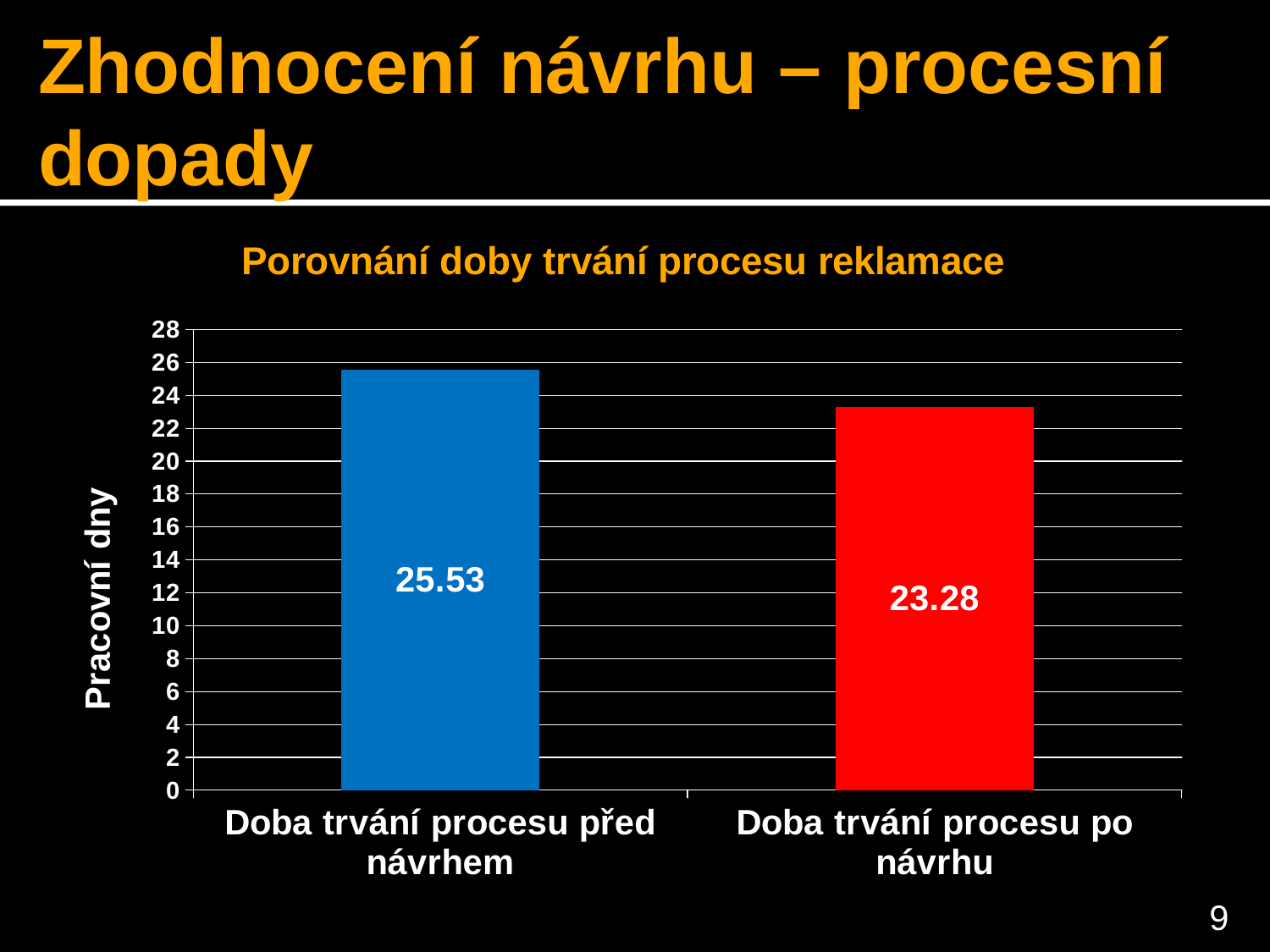
How many categories are shown in the chart? 2 What is the value for "Doba trvání procesu po návrhu"? 23.28 Which is larger: the value for "Doba trvání procesu před návrhem" or the value for "Doba trvání procesu po návrhu"? Doba trvání procesu před návrhem What is the difference between the value for "Doba trvání procesu před návrhem" and the value for "Doba trvání procesu po návrhu"? 2.25 What kind of chart is shown on the slide? bar chart What is the title of the chart? Porovnání doby trvání procesu reklamace Which category has the lowest value? Doba trvání procesu po návrhu Which category has the highest value? Doba trvání procesu před návrhem Is the value for "Doba trvání procesu před návrhem" greater or less than 24? greater Is the value for "Doba trvání procesu po návrhu" greater or less than 24? less What is the label of the vertical axis? Pracovní dny What is the value for "Doba trvání procesu před návrhem"? 25.53